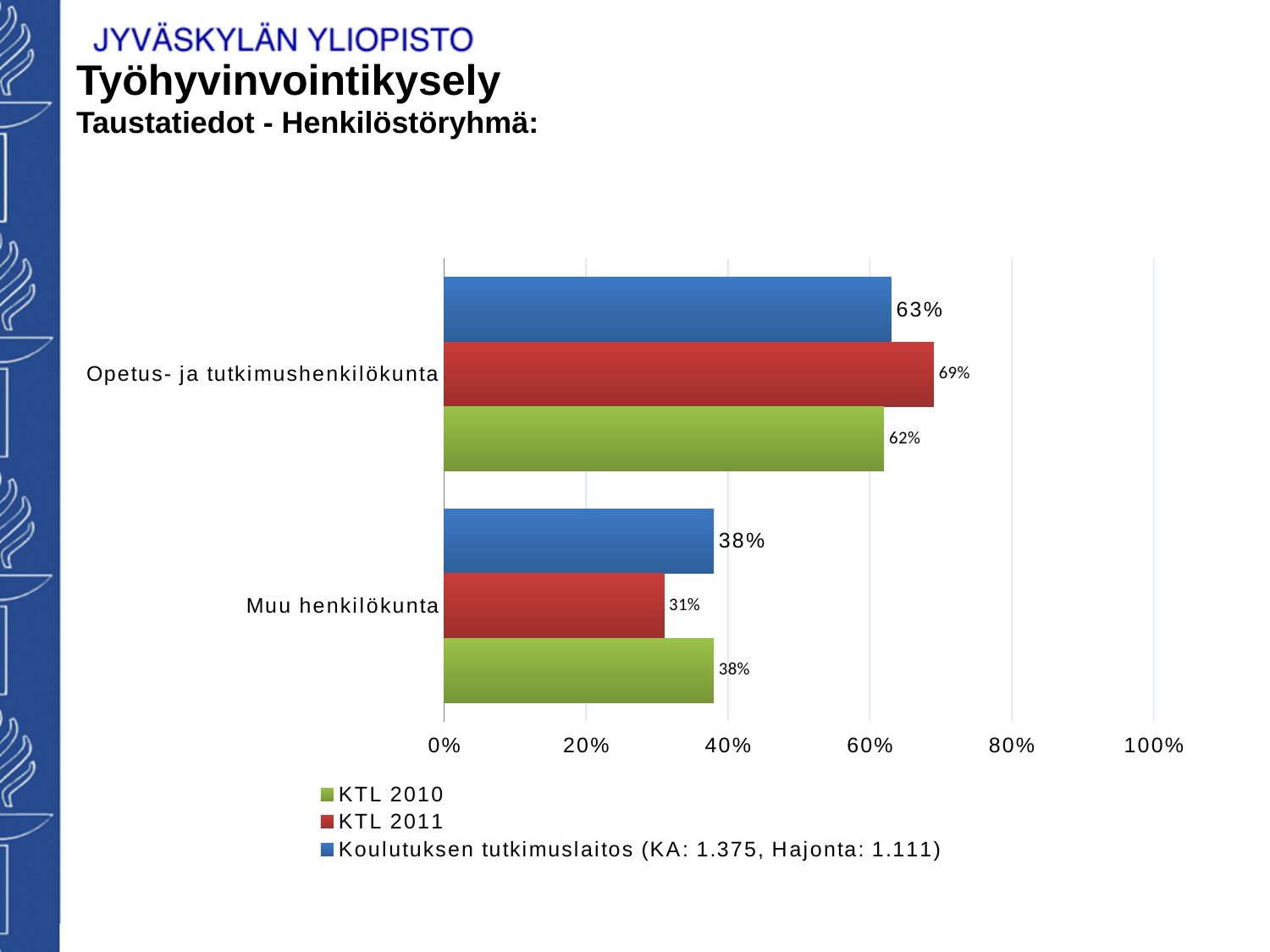
Which is larger for Muu henkilökunta: the KTL 2010 value or the KTL 2011 value? KTL 2010 What is the value for Opetus- ja tutkimushenkilökunta in the KTL 2011 series? 69% Which series has the highest value for Opetus- ja tutkimushenkilökunta? KTL 2011 What is the value for Opetus- ja tutkimushenkilökunta in the Koulutuksen tutkimuslaitos series? 63% How many series does the legend list? 3 Is the KTL 2011 value for Opetus- ja tutkimushenkilökunta greater or less than 60%? greater Which series has the lowest value for Muu henkilökunta? KTL 2011 What is the value for Muu henkilökunta in the KTL 2010 series? 38% What kind of chart is shown on the slide? Bar chart How many categories are shown on the chart? 2 What is the difference between the KTL 2011 and KTL 2010 values for Opetus- ja tutkimushenkilökunta? 7% What is the value for Muu henkilökunta in the KTL 2011 series? 31%